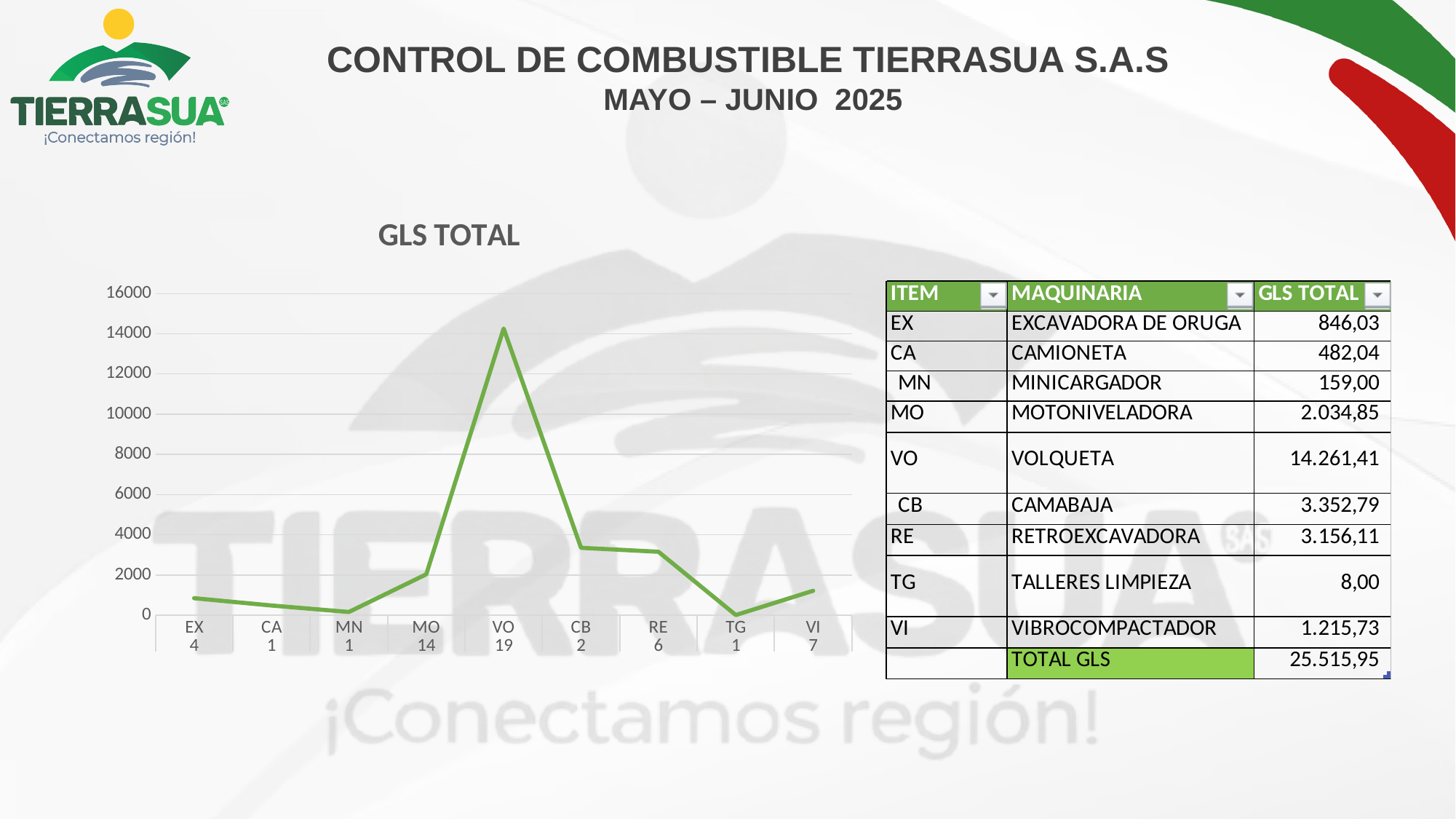
What is the TOTAL GLS shown in the table? 25.515,95 In the GLS TOTAL chart, is the value for CB greater or less than 4000? less How many categories are plotted along the x axis of the GLS TOTAL chart? 9 In the GLS TOTAL chart, is the value for RE greater or less than 2000? greater What kind of chart is the GLS TOTAL chart? line chart According to the table, which item has the lowest GLS TOTAL? TG Which has the larger value in the GLS TOTAL chart, VO or CB? VO Using the table values, what is the difference between the GLS TOTAL of CB and RE? 196,68 In the GLS TOTAL chart, is the value for VO greater or less than 12000? greater According to the table, what is the GLS TOTAL for CAMABAJA (CB)? 3.352,79 According to the table, what is the GLS TOTAL for VOLQUETA (VO)? 14.261,41 Which category has the highest value in the GLS TOTAL chart? VO